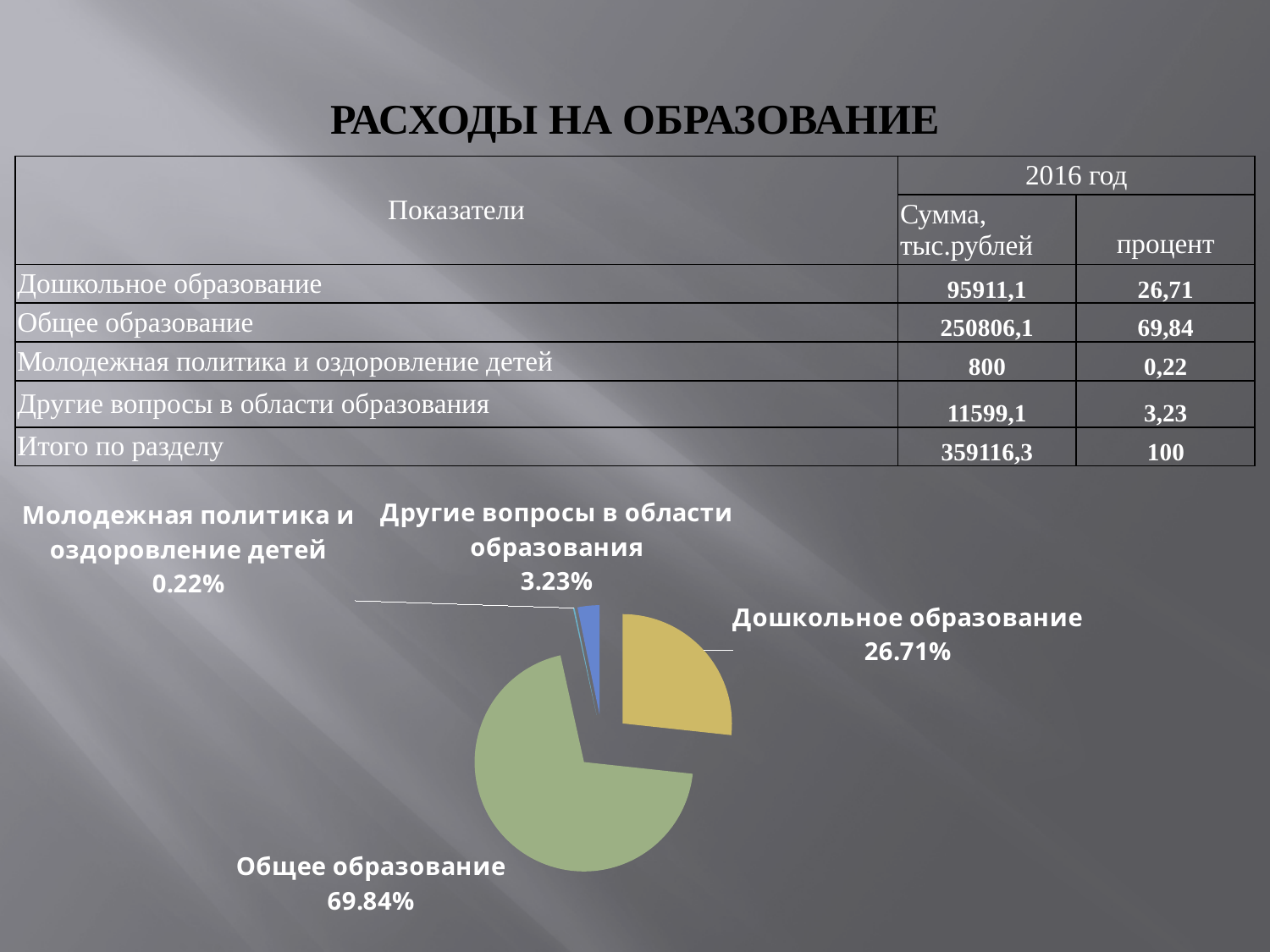
What is the combined share of Другие вопросы в области образования and Молодежная политика и оздоровление детей in the pie chart? 3.45% What share of the pie chart does Общее образование have? 69.84% What kind of chart is shown on the slide? pie chart What share of the pie chart does Дошкольное образование have? 26.71% What is the difference in percentage points between Общее образование and Дошкольное образование in the pie chart? 43.13 Which slice of the pie chart is the smallest? Молодежная политика и оздоровление детей How many slices does the pie chart have? 4 What share of the pie chart does Другие вопросы в области образования have? 3.23% Which slice of the pie chart is the largest? Общее образование What colour is the Общее образование slice in the pie chart? green Which is larger in the pie chart: Дошкольное образование or Другие вопросы в области образования? Дошкольное образование What share of the pie chart does Молодежная политика и оздоровление детей have? 0.22%